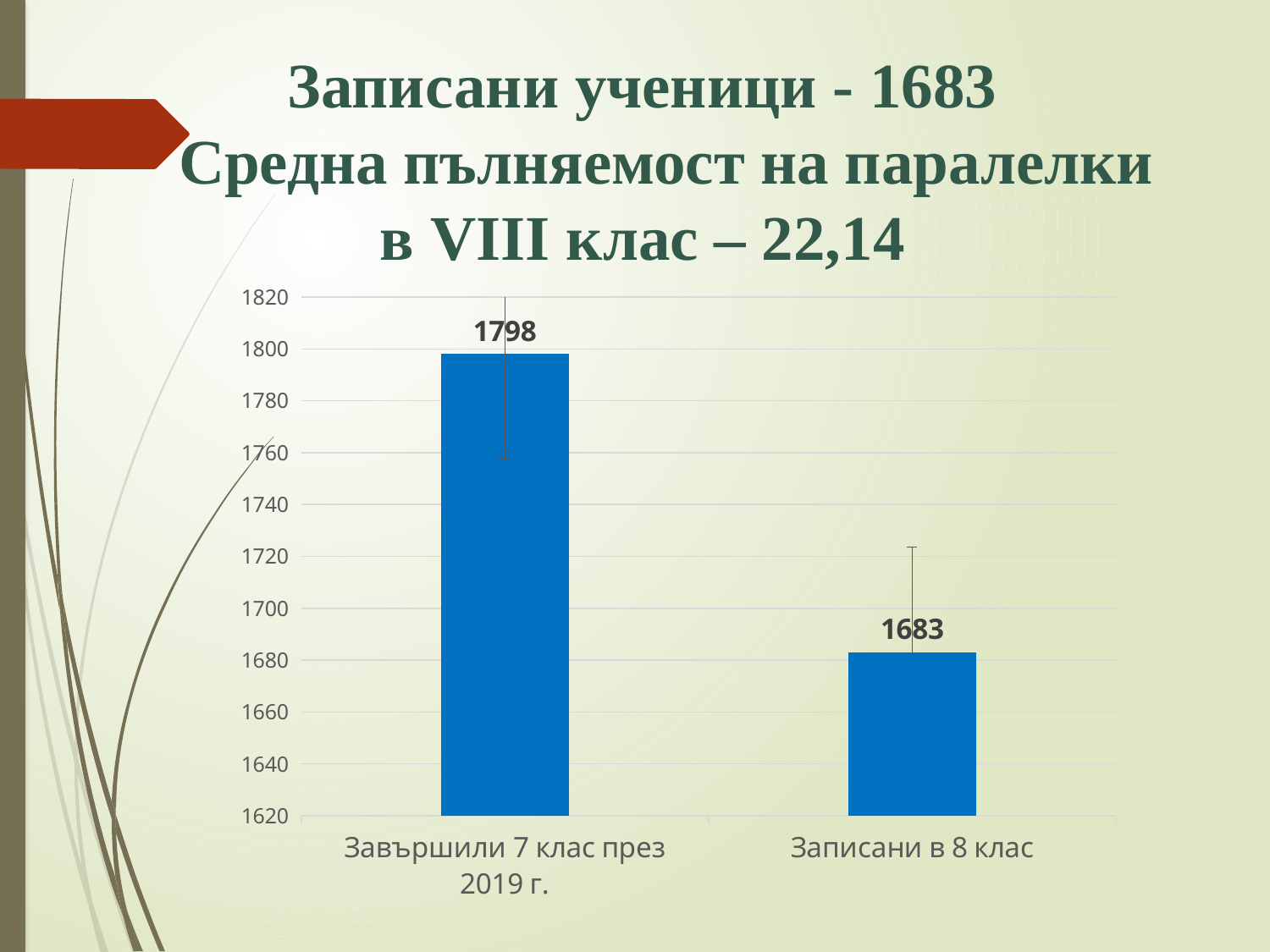
How many categories are shown on the chart? 2 What is the difference between the values for "Завършили 7 клас през 2019 г." and "Записани в 8 клас"? 115 What kind of chart is shown on the slide? bar chart What is the value for "Завършили 7 клас през 2019 г."? 1798 Is the value for "Записани в 8 клас" greater or less than 1700? less Which is larger: the value for "Завършили 7 клас през 2019 г." or for "Записани в 8 клас"? Завършили 7 клас през 2019 г. Which category has the highest value? Завършили 7 клас през 2019 г. What colour are the bars in the chart? blue What is the value for "Записани в 8 клас"? 1683 Do the values rise or fall from left to right along the x axis? fall Which category has the lowest value? Записани в 8 клас Is the value for "Завършили 7 клас през 2019 г." greater or less than 1780? greater